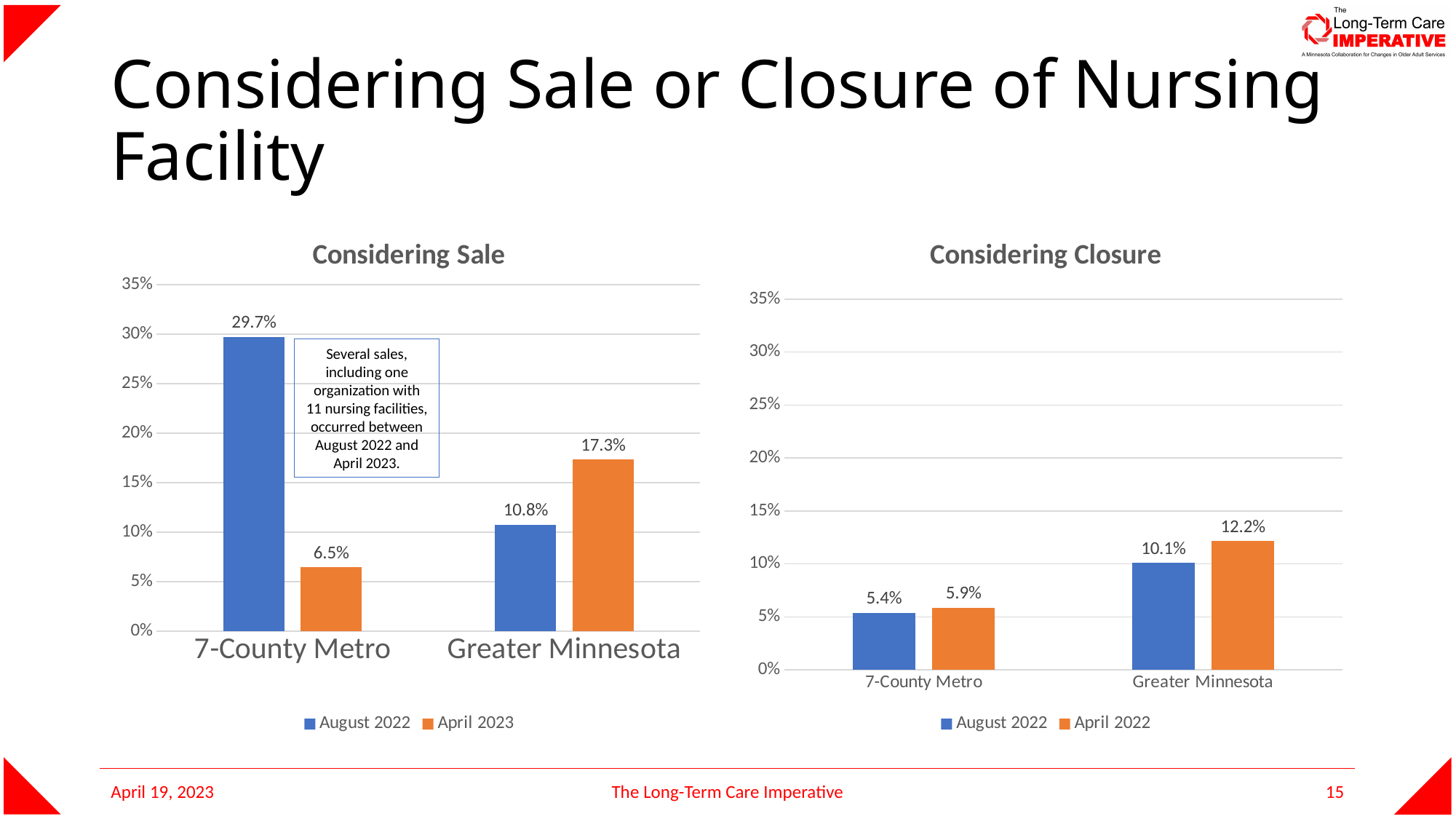
In the Considering Closure chart, which bar is the lowest? 7-County Metro, August 2022 In the Considering Closure chart, what is the August 2022 value for Greater Minnesota? 10.1% In the Considering Sale chart, what is the difference between the August 2022 and April 2023 values for 7-County Metro? 23.2% In the Considering Closure chart, what is the difference between the April 2022 and August 2022 values for Greater Minnesota? 2.1% How many series does the legend of the Considering Closure chart list? 2 In the Considering Sale chart, is the April 2023 value for 7-County Metro greater or less than 10%? less In the Considering Closure chart, what is the April 2022 value for 7-County Metro? 5.9% In the Considering Sale chart, what is the April 2023 value for Greater Minnesota? 17.3% What kind of chart is the Considering Sale chart? Bar chart In the Considering Sale chart, what is the August 2022 value for 7-County Metro? 29.7% In the Considering Sale chart, which is larger for Greater Minnesota: August 2022 or April 2023? April 2023 In the Considering Sale chart, which bar is the highest? 7-County Metro, August 2022